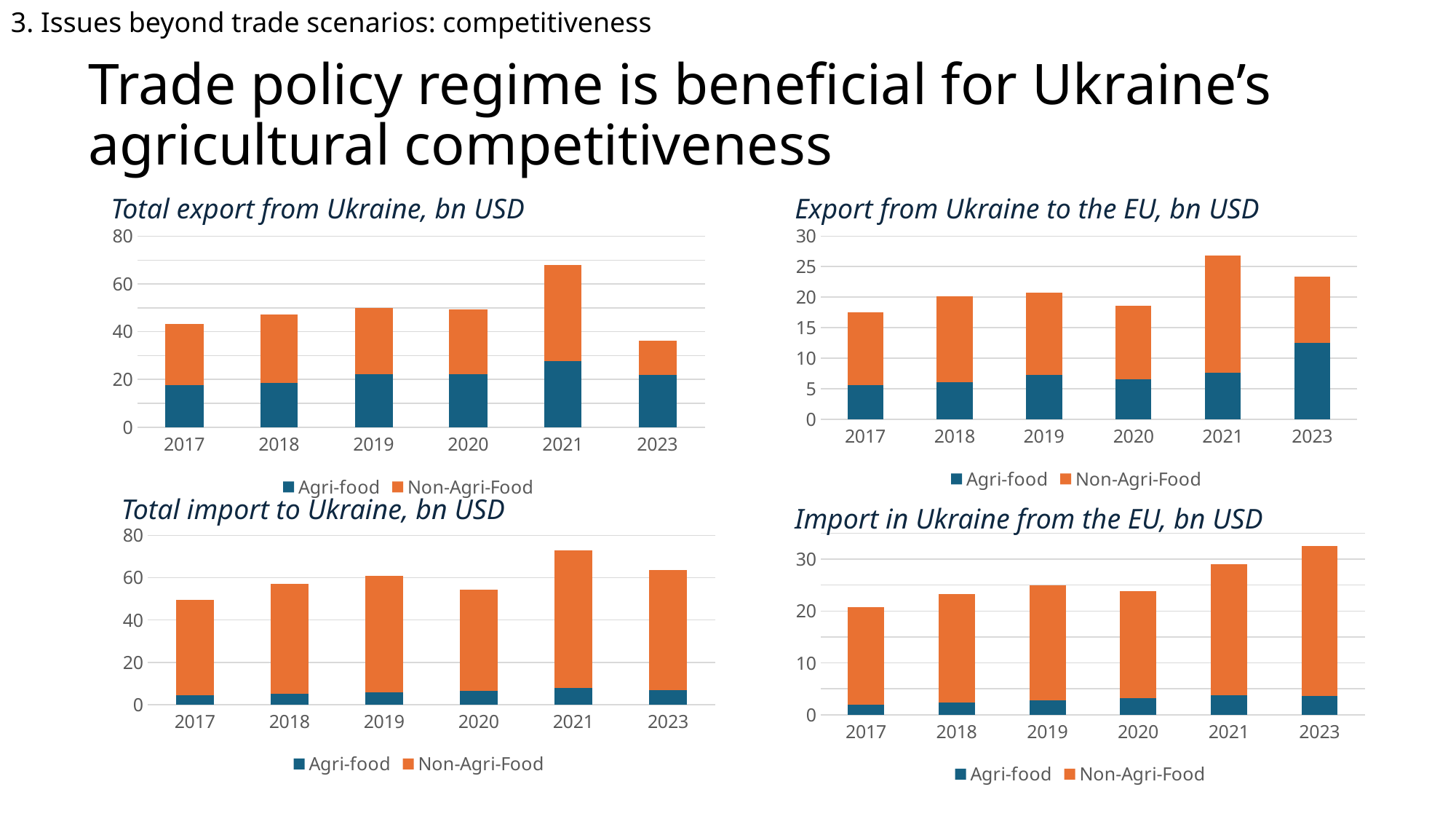
What kind of chart is the 'Total export from Ukraine, bn USD' chart? Stacked bar chart On the 'Export from Ukraine to the EU, bn USD' chart, which year has the highest total export to the EU? 2021 On the 'Total export from Ukraine, bn USD' chart, which year has the lowest total export? 2023 On the 'Export from Ukraine to the EU, bn USD' chart, is the Agri-food value for 2023 greater or less than 10? greater How many series does the legend list on the 'Export from Ukraine to the EU, bn USD' chart? 2 On the 'Import in Ukraine from the EU, bn USD' chart, which year has the highest total import from the EU? 2023 How many years are shown on the x axis of the 'Total import to Ukraine, bn USD' chart? 6 On the 'Total export from Ukraine, bn USD' chart, is the total for 2021 greater or less than 60? greater On the 'Import in Ukraine from the EU, bn USD' chart, is the total for 2017 greater or less than 30? less On the 'Total export from Ukraine, bn USD' chart, which year has the highest total export? 2021 On the 'Total import to Ukraine, bn USD' chart, which year has the lowest total import? 2017 Which colour represents Non-Agri-Food in the legends of the charts? Orange